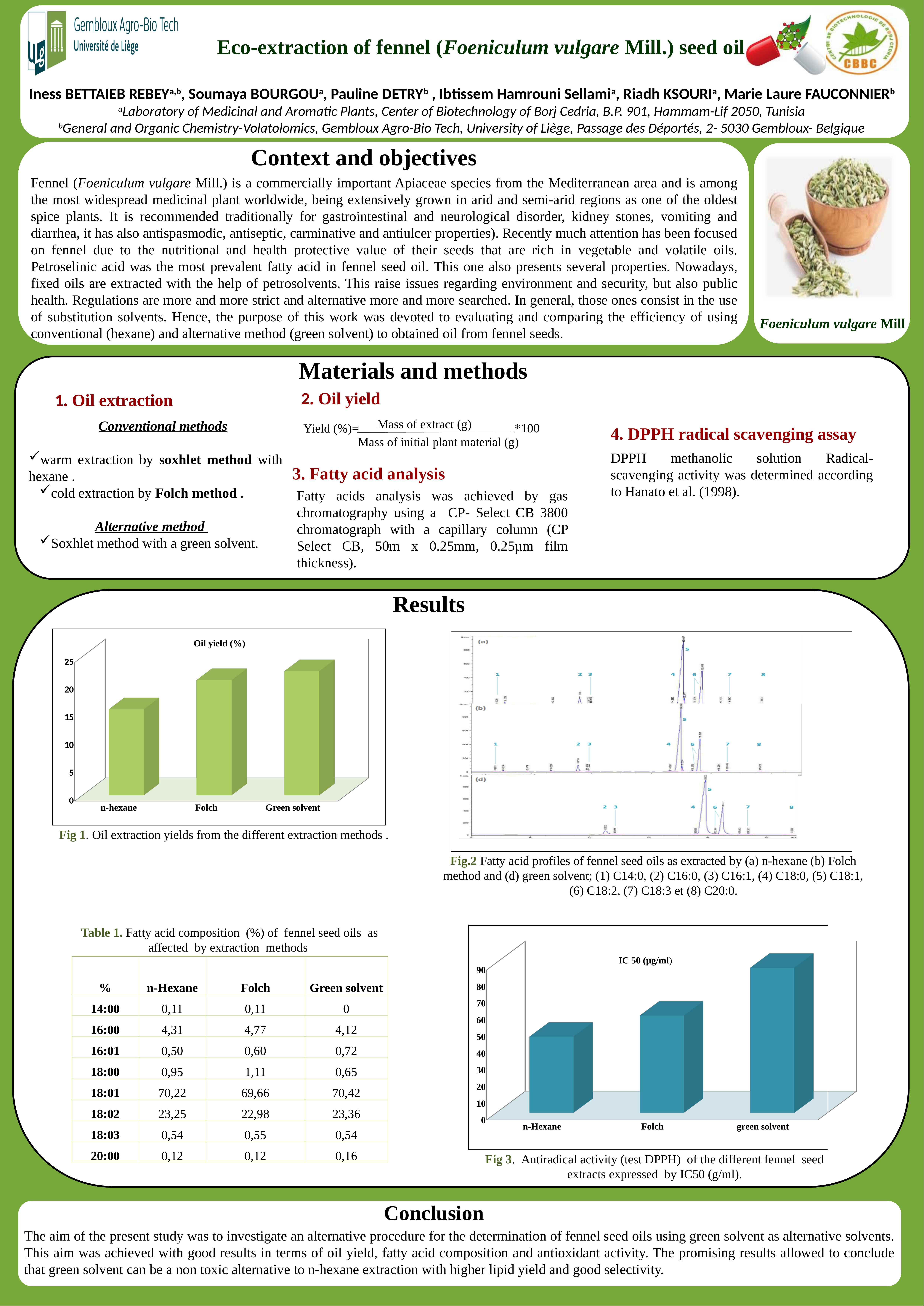
In the IC 50 (µg/ml) chart, which extract has the lowest IC50 value? n-Hexane How many extraction methods are shown on the x axis of the Oil yield (%) chart? 3 In the Oil yield (%) chart, which extraction method has the lowest oil yield? n-hexane What kind of chart is the IC 50 (µg/ml) chart (Fig 3)? bar chart In the Oil yield (%) chart, is the value for n-hexane greater or less than 20? less In the Oil yield (%) chart, is the value for n-hexane greater or less than 10? greater In the IC 50 (µg/ml) chart, which extract has the highest IC50 value? green solvent What kind of chart is the Oil yield (%) chart (Fig 1)? bar chart In the Oil yield (%) chart, do the values rise or fall from n-hexane to Green solvent along the x axis? rise In the IC 50 (µg/ml) chart, is the value for green solvent greater or less than 80? greater In the Oil yield (%) chart, which is larger, the value for n-hexane or the value for Green solvent? Green solvent